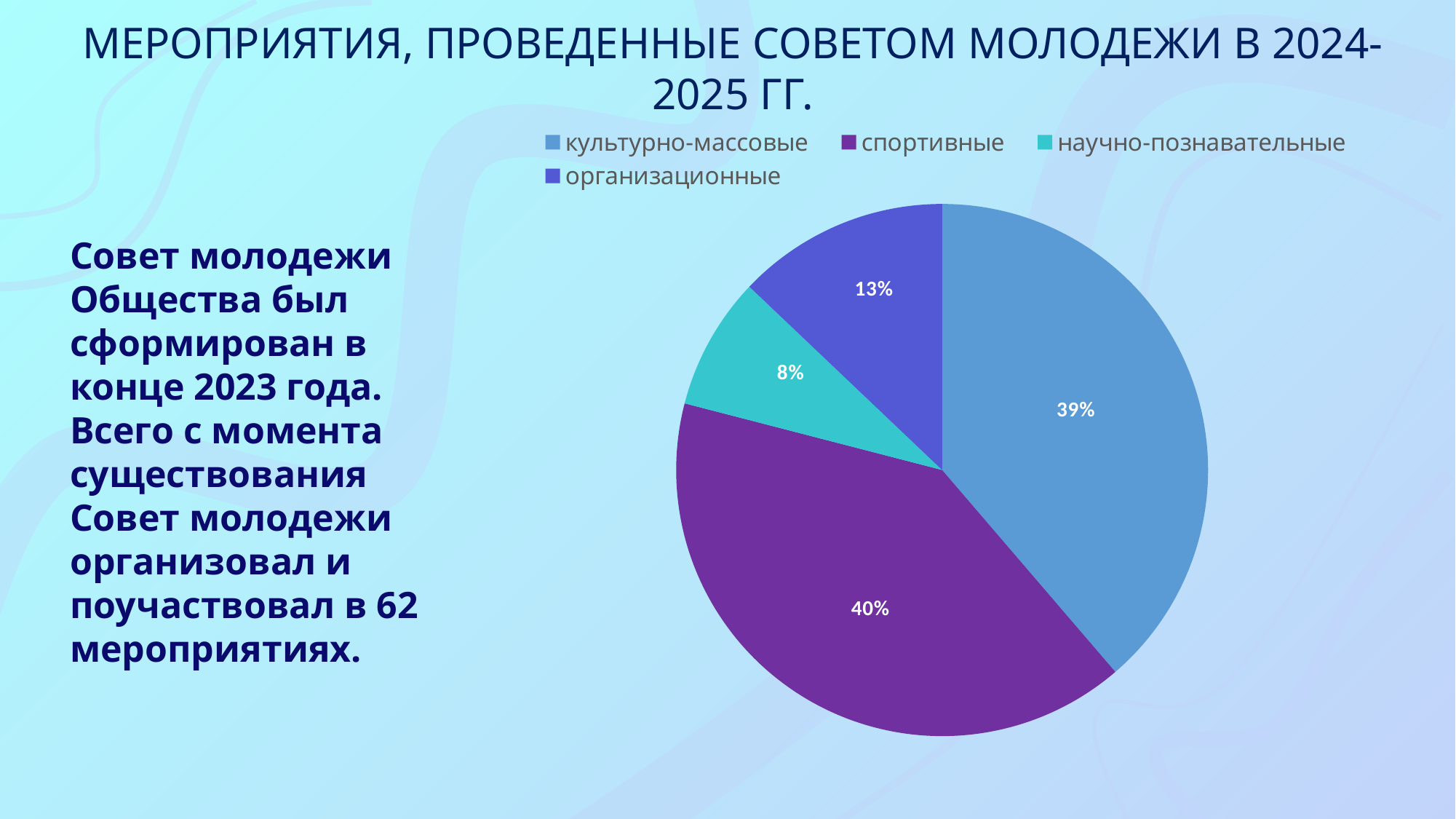
What is the difference in percentage points between the 'организационные' and 'научно-познавательные' slices? 5% What share of the pie does the 'научно-познавательные' slice have? 8% Which category has the largest slice of the pie? спортивные How many slices does the pie chart have? 4 What is the title of the chart on the slide? МЕРОПРИЯТИЯ, ПРОВЕДЕННЫЕ СОВЕТОМ МОЛОДЕЖИ В 2024-2025 ГГ. Which is larger: the 'организационные' slice or the 'научно-познавательные' slice? организационные Which category has the smallest slice of the pie? научно-познавательные What share of the pie does the 'культурно-массовые' slice have? 39% What share of the pie does the 'спортивные' slice have? 40% How many entries does the legend list? 4 What kind of chart is shown on the slide? pie chart